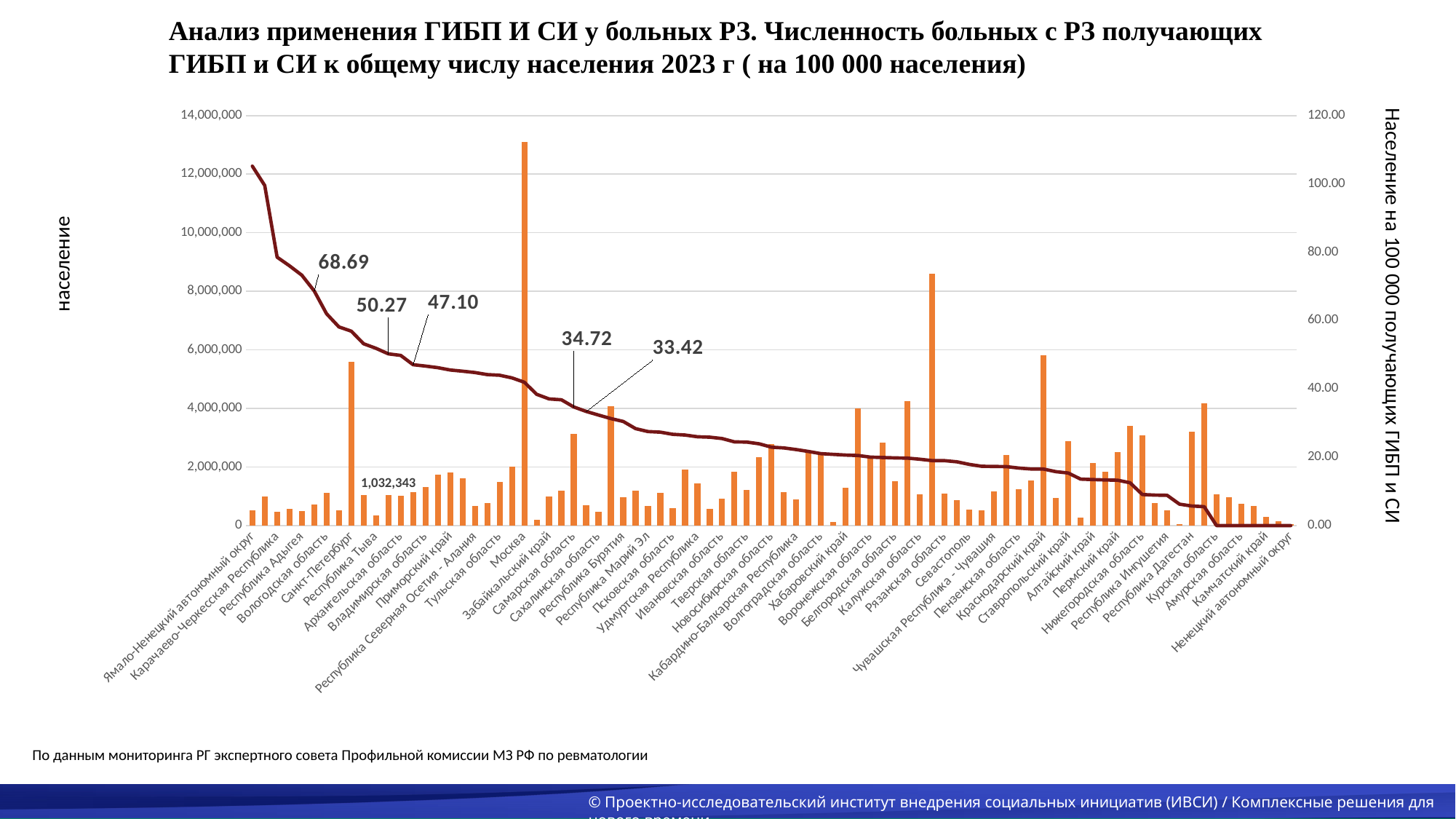
What is the difference between the line data labels 34.72 and 33.42? 1.30 What is the lowest value printed as a data label on the dark red line? 33.42 Is the population bar for Санкт-Петербург greater or less than 4,000,000? greater Does the dark red line rise or fall from left to right along the x axis? It falls Which has the larger population bar, Москва or Санкт-Петербург? Москва What is the highest value printed as a data label on the dark red line? 68.69 Is the population bar for Москва greater or less than 12,000,000? greater Which region has the tallest orange bar (largest population)? Москва What kind of chart is shown on the slide? A bar chart combined with a line What is the maximum tick value shown on the right-hand axis? 120.00 What is the difference between the line data labels 50.27 and 47.10? 3.17 What is the title of the left-hand vertical axis? население